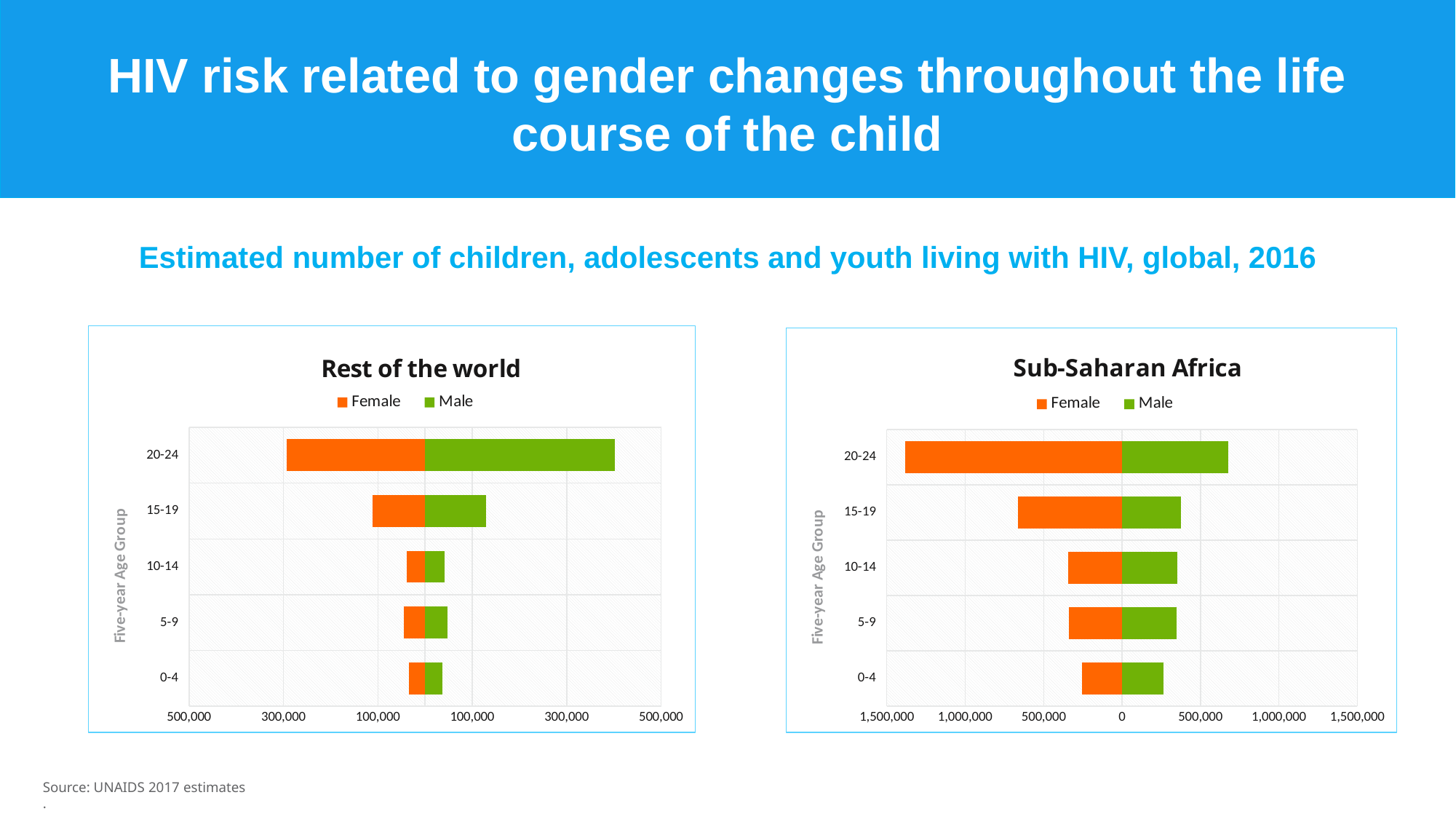
In the "Rest of the world" chart, for the 20-24 age group, is the Female or the Male value larger? Male In the "Rest of the world" chart, is the Male value for the 20-24 age group greater or less than 300,000? greater How many series does the legend of the "Sub-Saharan Africa" chart list? 2 In the "Sub-Saharan Africa" chart, which age group has the largest number of females living with HIV? 20-24 In the "Rest of the world" chart, which age group has the largest number of males living with HIV? 20-24 In the "Sub-Saharan Africa" chart, is the Male value for the 15-19 age group greater or less than 500,000? less How many age groups are shown on the "Rest of the world" chart? 5 In the "Sub-Saharan Africa" chart, is the Female value for the 20-24 age group greater or less than 1,000,000? greater In the "Sub-Saharan Africa" chart, for the 20-24 age group, is the Female or the Male value larger? Female What kind of chart is the "Rest of the world" chart? bar chart What colour represents the Female series in the "Sub-Saharan Africa" chart? Orange